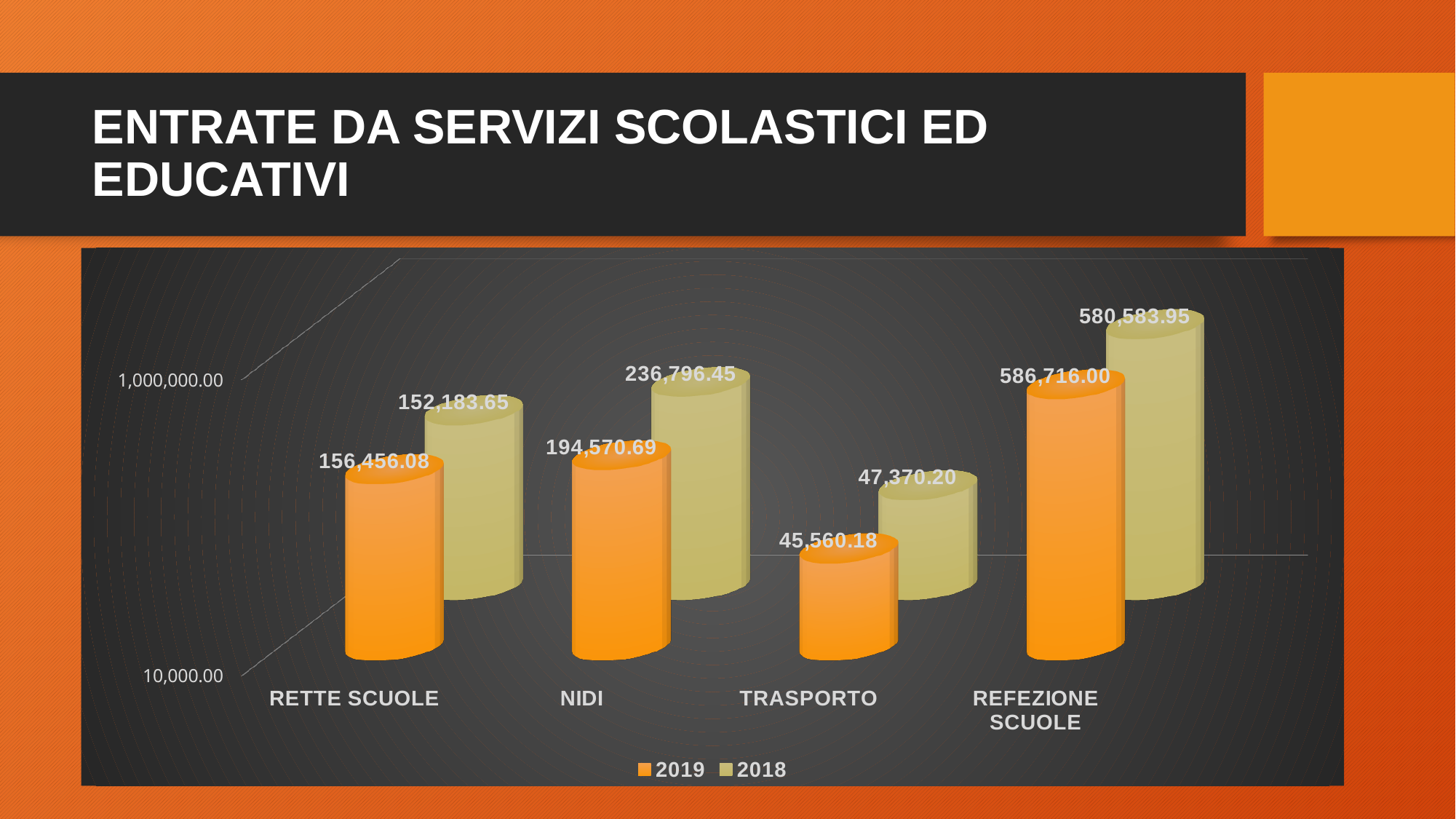
What is the 2018 value for REFEZIONE SCUOLE? 580,583.95 What is the difference between the 2019 and 2018 values for REFEZIONE SCUOLE? 6,132.05 For NIDI, which year has the larger value, 2019 or 2018? 2018 How many series does the legend list? 2 What is the 2019 value for TRASPORTO? 45,560.18 What is the difference between the 2018 and 2019 values for NIDI? 42,225.76 Which category has the lowest 2018 value? TRASPORTO What is the 2019 value for NIDI? 194,570.69 What is the 2018 value for RETTE SCUOLE? 152,183.65 What kind of chart is shown on the slide? Bar chart How many categories are shown on the x axis? 4 Which category has the highest 2019 value? REFEZIONE SCUOLE